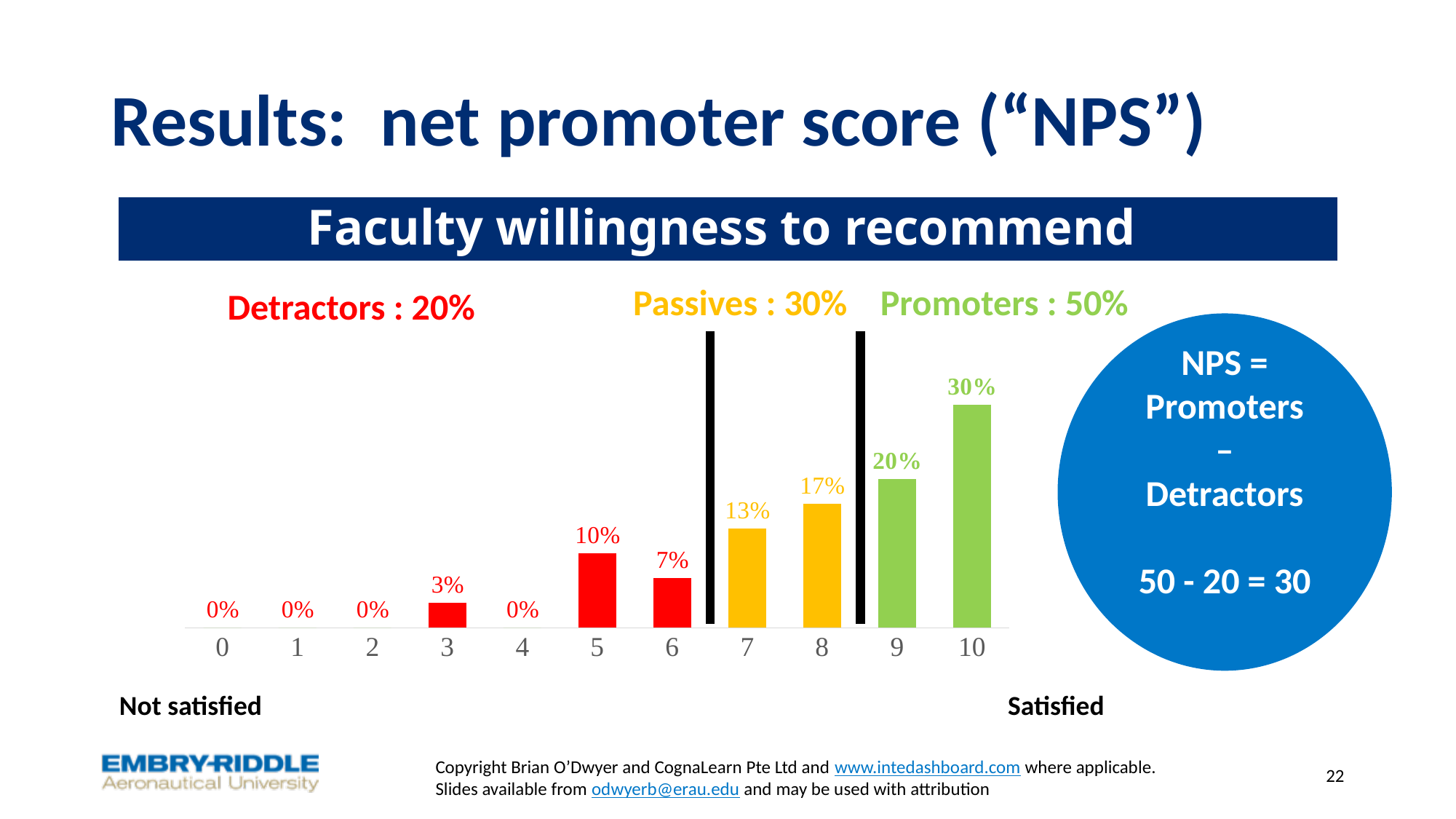
What colour are the bars for scores 9 and 10? green What is the title shown above the chart? Faculty willingness to recommend Which has a larger percentage, score 6 or score 8? 8 What percentage of faculty gave a score of 5? 10% What percentage of faculty gave a score of 7? 13% Which score has the highest percentage of faculty? 10 What is the difference between the percentages for scores 10 and 9? 10% What is the combined percentage for scores 7 and 8? 30% What percentage of faculty gave a score of 10? 30% What kind of chart is shown on the slide? bar chart Do the percentages generally rise or fall as the score increases from 5 to 10? rise How many score categories are shown on the x axis? 11